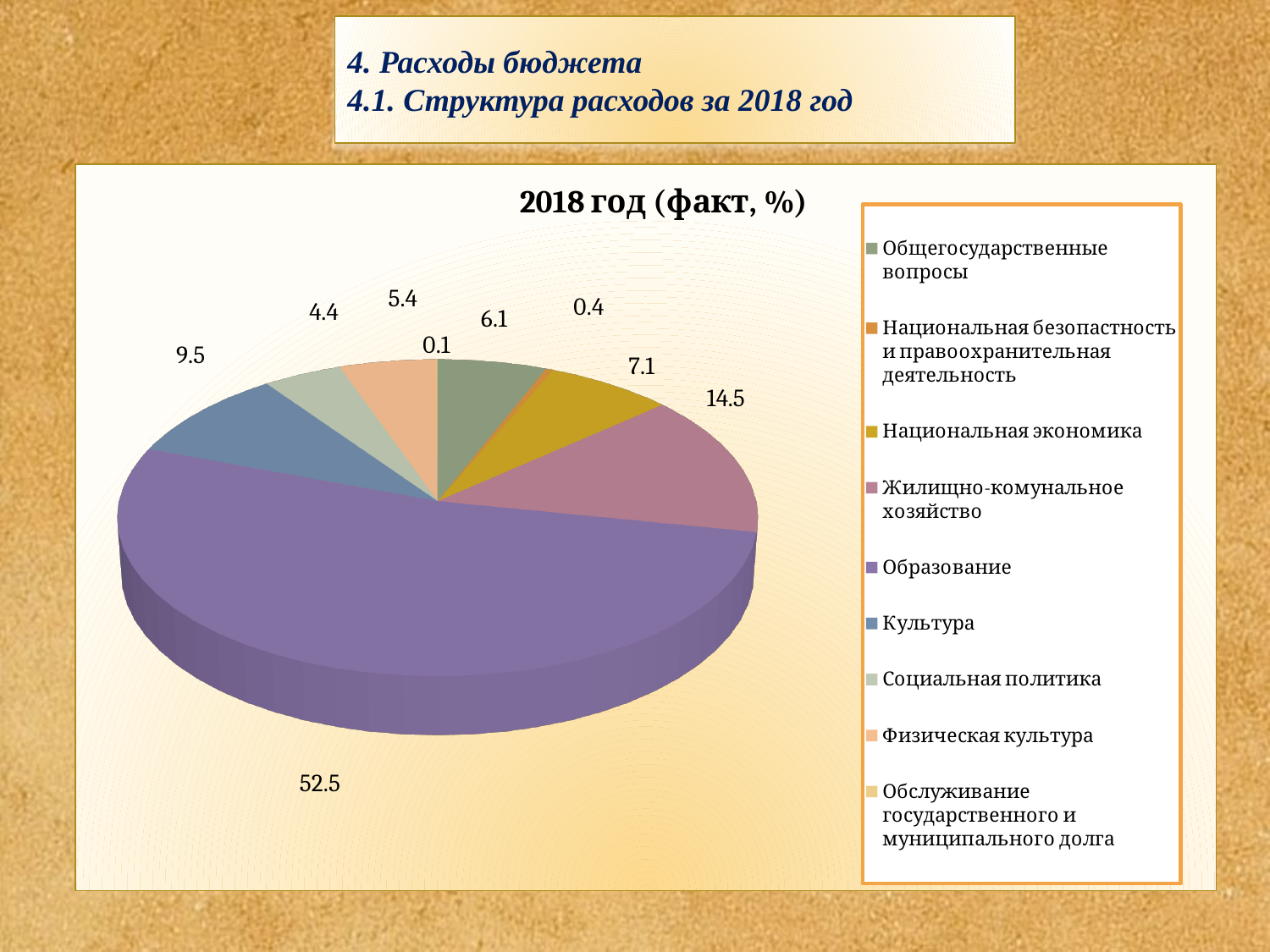
What is the value for Образование? 52.5 What is the value for Общегосударственные вопросы? 6.1 Which category has the largest share of the pie? Образование What kind of chart is shown on the slide? pie chart How many categories does the legend list? 9 What is the value for Национальная экономика? 7.1 What is the value for Жилищно-коммунальное хозяйство? 14.5 Which is larger, the value for Культура or the value for Физическая культура? Культура What is the value for Культура? 9.5 Which category has the smallest share of the pie? Обслуживание государственного и муниципального долга What is the title of the chart? 2018 год (факт, %) What is the difference between the values for Образование and Жилищно-коммунальное хозяйство? 38